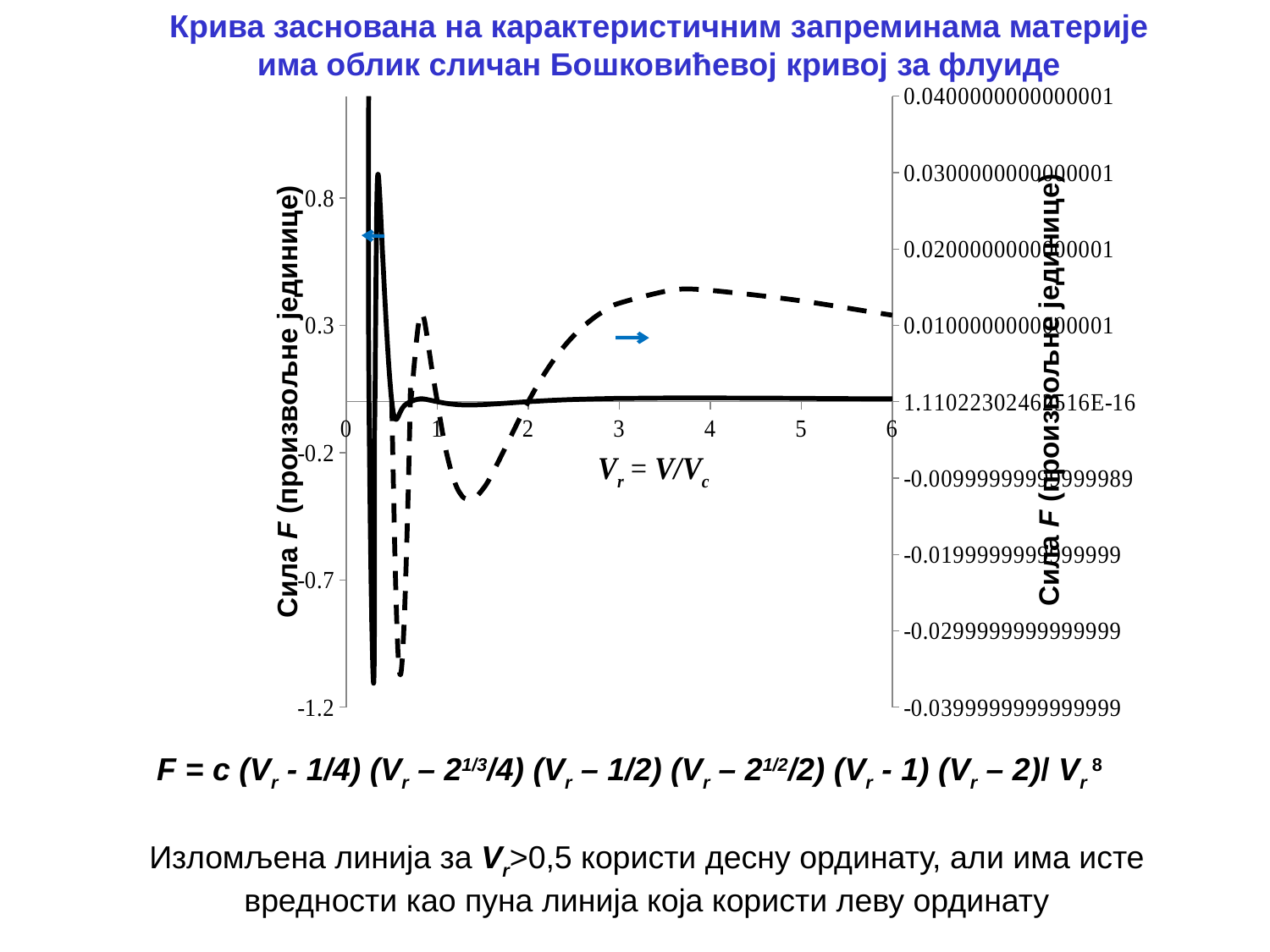
What is the highest tick value shown on the x axis? 6 Which line uses the right ordinate axis, the solid line or the dashed line? the dashed line What is the label of the x axis of the chart? Vr = V/Vc Does the dashed line rise or fall as Vr goes from 4 to 6? fall Is the value of the dashed line at Vr = 1.3 greater or less than 0 on the right axis? less Does the dashed line rise or fall as Vr goes from 2 to 3.5? rise What is the lowest tick value shown on the left y axis? -1.2 How many curves (series) are plotted on the chart? 2 Is the value of the solid line at Vr = 3 greater or less than 0.3 on the left axis? less What kind of chart is shown on the slide? line chart What is the highest tick value shown on the left y axis? 0.8 Is the value of the dashed line at Vr = 4 greater or less than 0.01 on the right axis? greater